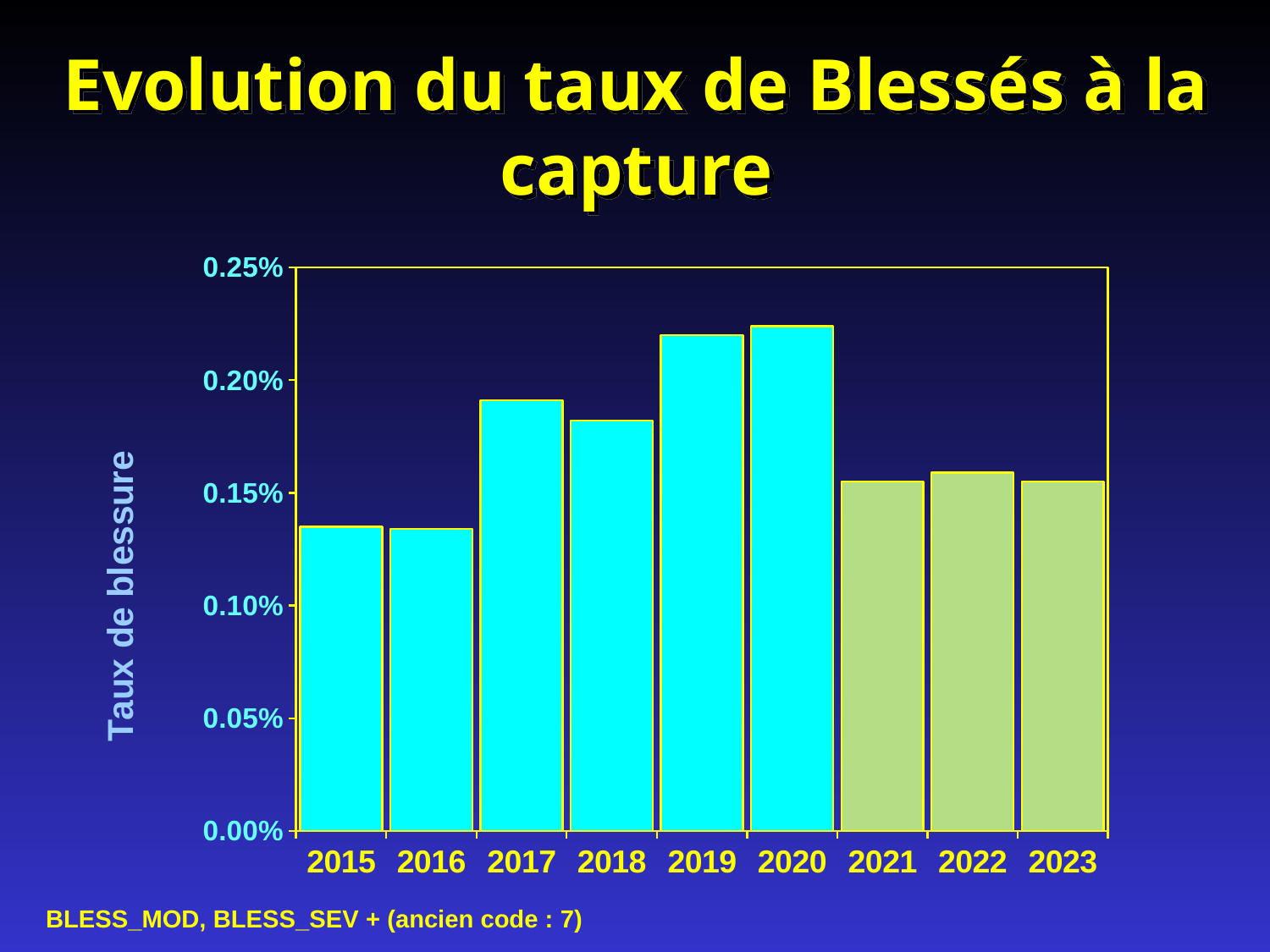
What is the title of the y axis? Taux de blessure Which is larger, the value for 2019 or the value for 2021? 2019 Do the values rise or fall from 2016 to 2020? rise Is the value for 2017 greater or less than 0.20%? less Which years are shown with green bars instead of cyan bars? 2021, 2022, 2023 What kind of chart is shown on the slide? bar chart Which is larger, the value for 2017 or the value for 2018? 2017 Is the value for 2022 greater or less than 0.20%? less Is the value for 2015 greater or less than 0.15%? less How many years are shown on the x axis of the chart? 9